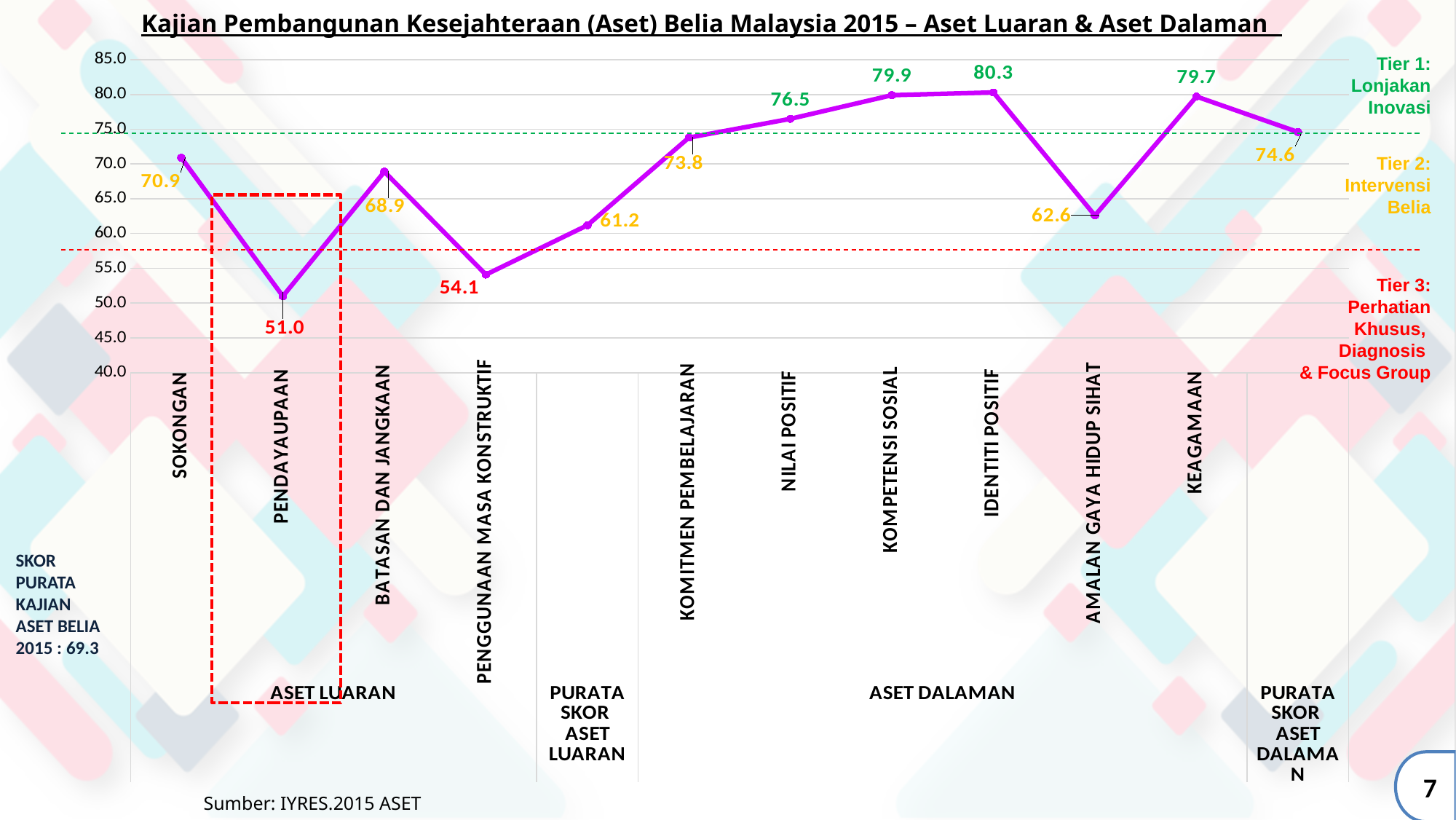
What is the PURATA SKOR ASET DALAMAN value? 74.6 Which is larger, the score for BATASAN DAN JANGKAAN or the score for PENGGUNAAN MASA KONSTRUKTIF? BATASAN DAN JANGKAAN What is the difference between PURATA SKOR ASET DALAMAN and PURATA SKOR ASET LUARAN? 13.4 Which category has the lowest score? PENDAYAUPAAN What is the difference between the scores for KOMPETENSI SOSIAL and AMALAN GAYA HIDUP SIHAT? 17.3 How many categories are plotted on the x axis? 12 What is the score for PENDAYAUPAAN? 51.0 Which category has the highest score? IDENTITI POSITIF What is the score for IDENTITI POSITIF? 80.3 Is the score for NILAI POSITIF greater or less than 75.0? greater What kind of chart is shown on the slide? line chart What is the score for SOKONGAN? 70.9